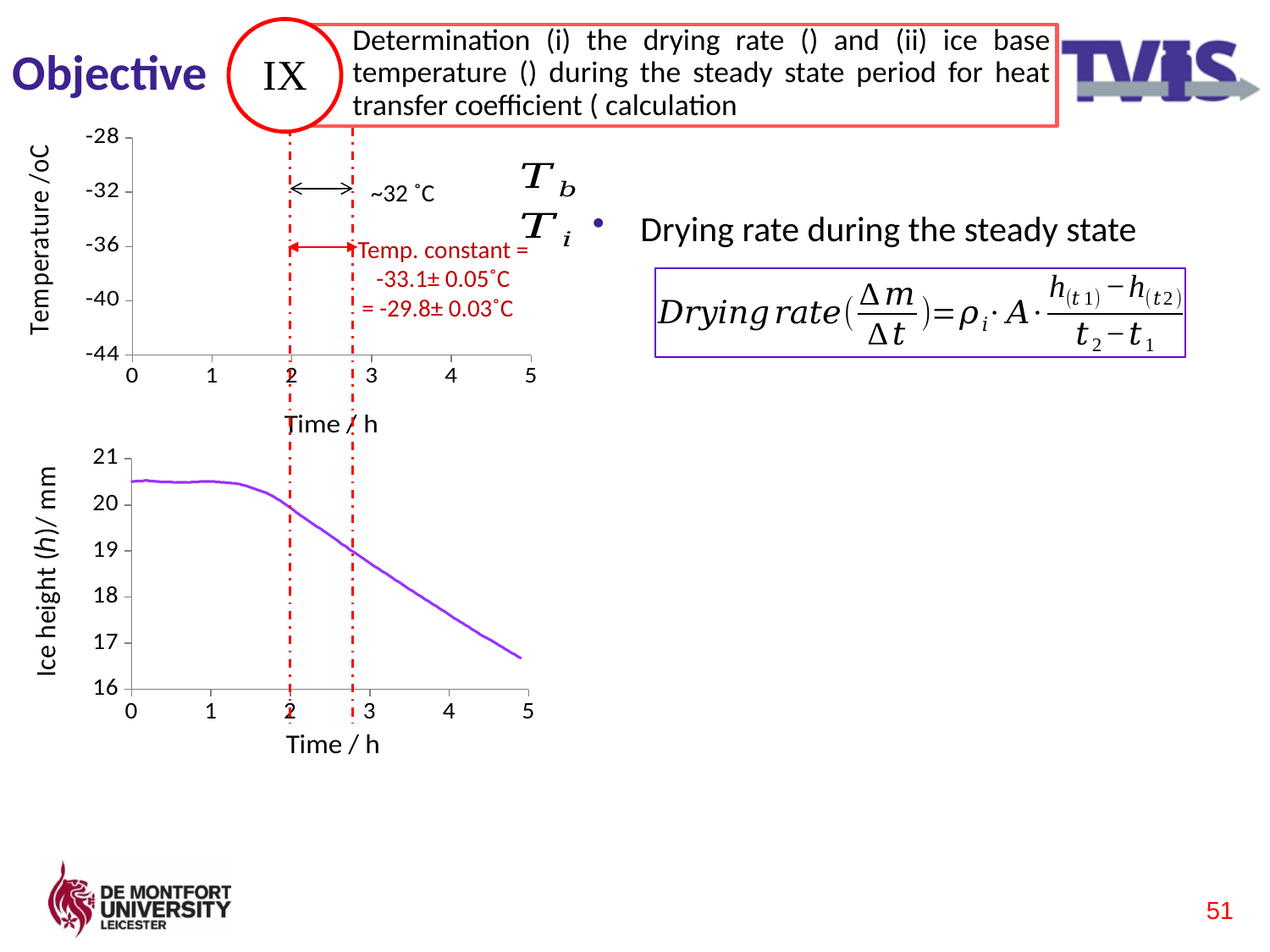
What is the x-axis label of the top chart? Time / h In the top chart (Temperature vs Time), what is the lowest value shown on the y-axis? -44 In the bottom chart (Ice height vs Time), is the ice height at time 1 h greater or less than 20 mm? greater In the bottom chart (Ice height vs Time), what is the highest value shown on the x-axis? 5 In the bottom chart (Ice height vs Time), is the ice height at time 4 h greater or less than 18 mm? less What kind of chart is the bottom chart (Ice height vs Time)? line chart In the top chart (Temperature vs Time), what is the second constant temperature value annotated? -29.8± 0.03˚C What is the y-axis label of the bottom chart? Ice height (h)/ mm In the bottom chart (Ice height vs Time), does the ice height rise or fall as time increases? fall In the bottom chart (Ice height vs Time), is the ice height larger at time 1 h or at time 4 h? time 1 h In the top chart (Temperature vs Time), what constant temperature is annotated for the first value? -33.1± 0.05˚C In the bottom chart (Ice height vs Time), is the ice height at time 0 h greater or less than 20 mm? greater